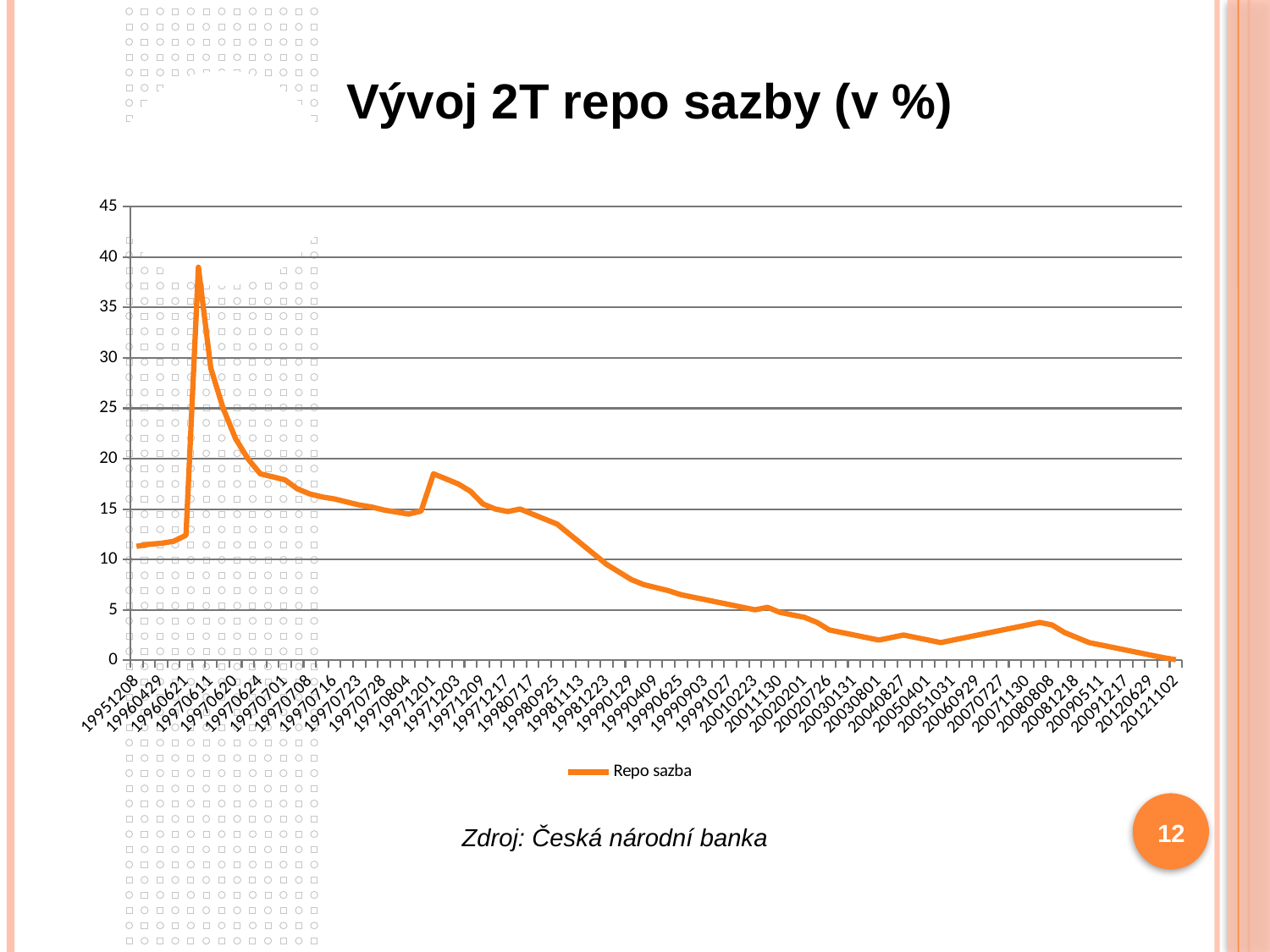
What is the name of the series shown in the legend? Repo sazba Is the value for 19951208 greater or less than 15? less At which x-axis date is the repo rate lowest? 20121102 Is the value for 19971201 greater or less than 15? greater What is the title of the chart? Vývoj 2T repo sazby (v %) Is the value for 19970611 greater or less than 35? less From 20080808 to 20121102, do the values rise or fall along the x axis? fall What kind of chart is shown on the slide? line chart How many series does the legend list? 1 Which has the larger value, 19971201 or 19990129? 19971201